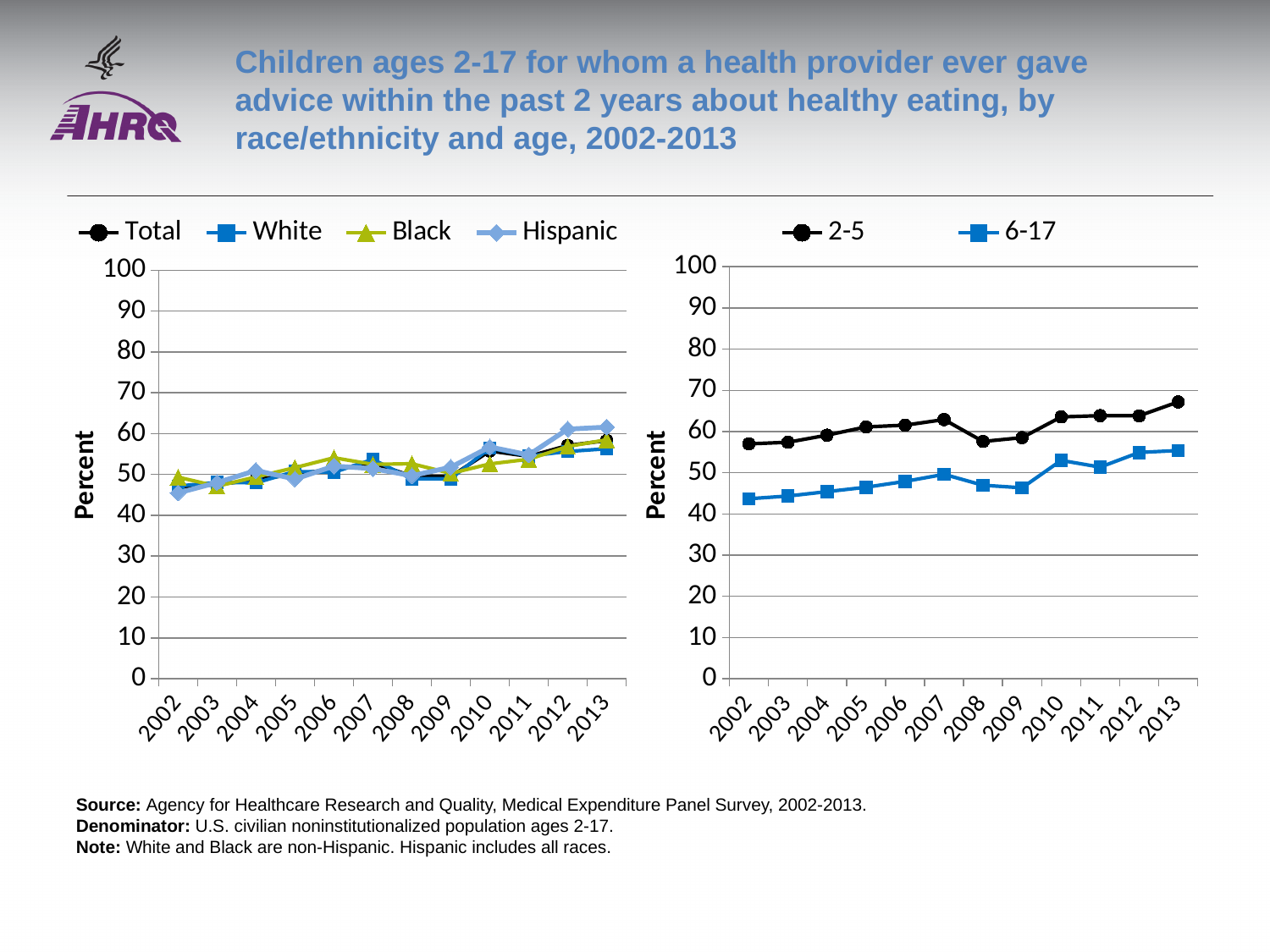
In the right chart, which series is higher in 2010, 2-5 or 6-17? 2-5 How many series does the legend of the right chart (2-5, 6-17) list? 2 In the left chart, is the value for Hispanic in 2002 greater or less than 50? less In the right chart, is the value for ages 6-17 in 2002 greater or less than 50? less What kind of chart is the left chart (Total, White, Black, Hispanic)? line chart In the right chart, does the value for ages 6-17 generally rise or fall from 2002 to 2013? rise In the right chart, is the value for ages 2-5 in 2013 greater or less than 60? greater In the left chart, which is larger in 2013, the value for Hispanic or the value for White? Hispanic How many years are shown on the x axis of the right chart? 12 How many series does the legend of the left chart list? 4 In the right chart, in which year is the value for ages 2-5 highest? 2013